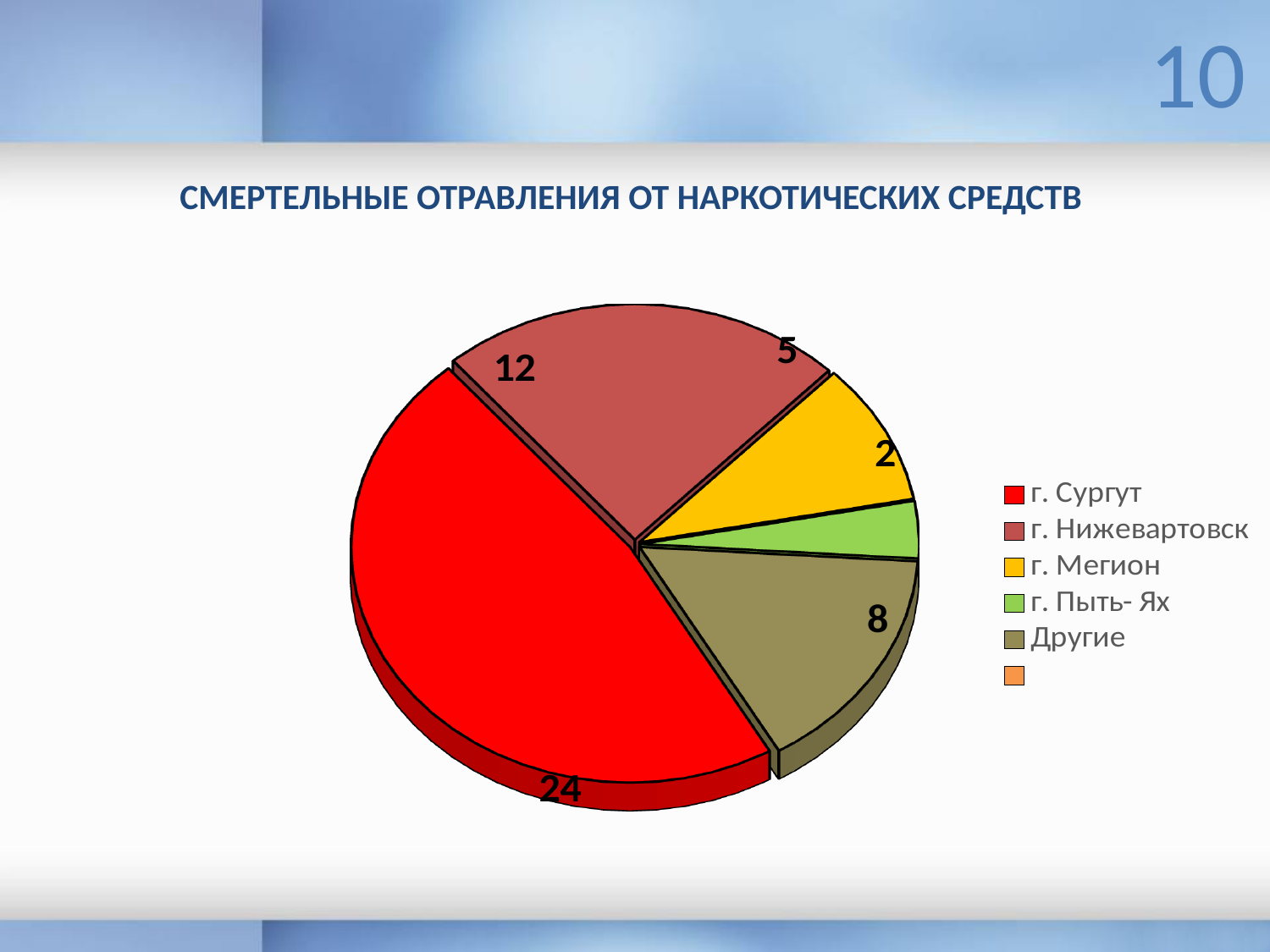
What is the value for г. Мегион? 5 What is the difference between the values for г. Сургут and г. Нижевартовск? 12 Which category has the largest slice? г. Сургут How many labelled slices does the pie chart have? 5 What is the title of the chart? СМЕРТЕЛЬНЫЕ ОТРАВЛЕНИЯ ОТ НАРКОТИЧЕСКИХ СРЕДСТВ What is the value for Другие? 8 What is the value for г. Сургут? 24 What type of chart is shown on the slide? pie chart Which is larger, the value for Другие or the value for г. Мегион? Другие What is the value for г. Нижевартовск? 12 What is the value for г. Пыть- Ях? 2 Which category has the smallest slice? г. Пыть- Ях